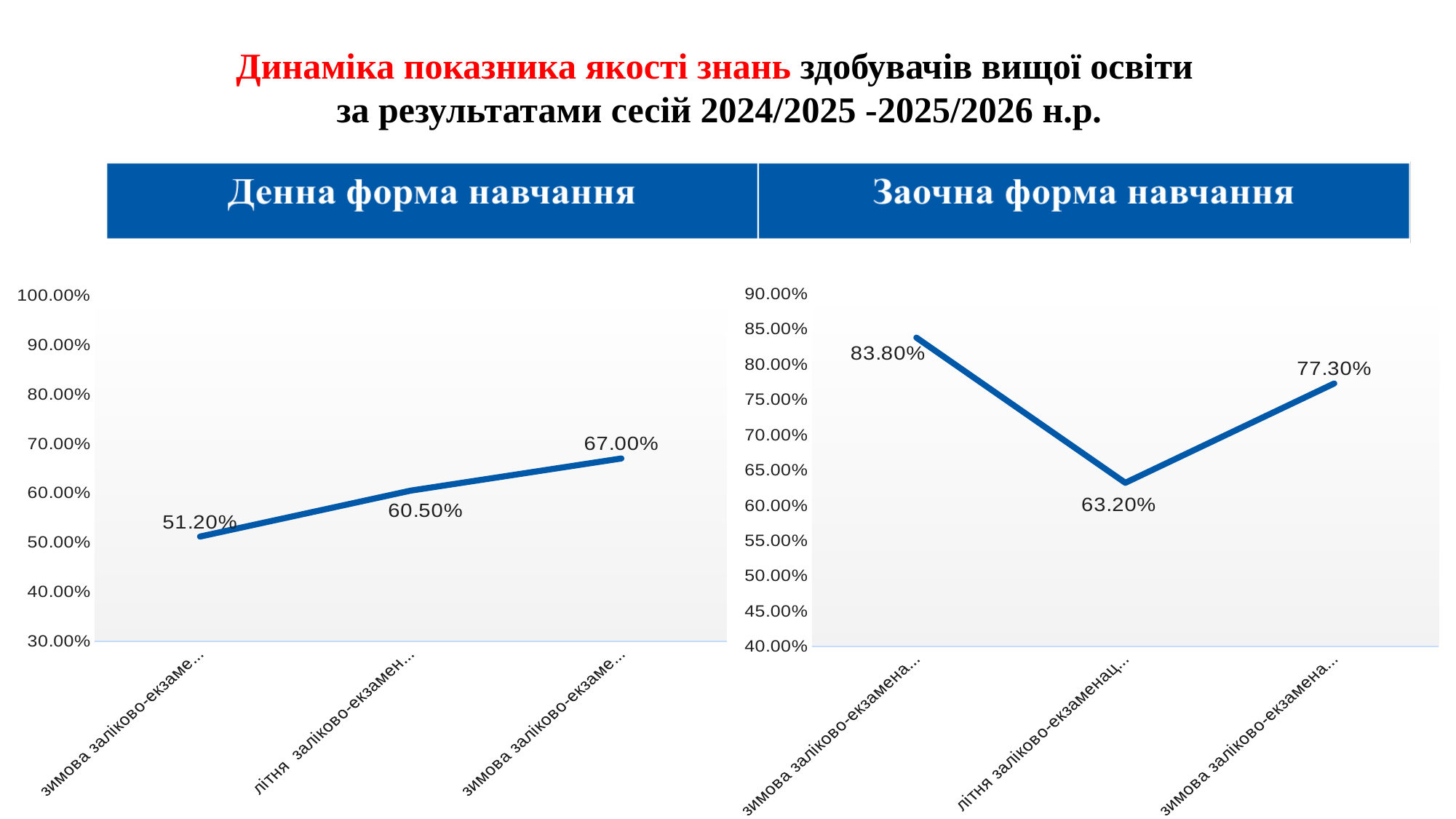
On the 'Заочна форма навчання' chart, what is the value of the second data point? 63.20% On the 'Денна форма навчання' chart, what is the difference between the last and the first data point? 15.80% On the 'Заочна форма навчання' chart, what is the value of the last data point? 77.30% How many data points are plotted on the 'Денна форма навчання' chart? 3 On the 'Денна форма навчання' chart, what is the value of the middle data point? 60.50% What type of chart is used for 'Заочна форма навчання'? Line chart On the 'Денна форма навчання' chart, what is the value of the first data point? 51.20% Which is larger: the last value on the 'Денна форма навчання' chart or the last value on the 'Заочна форма навчання' chart? The last value on the 'Заочна форма навчання' chart (77.30%) On the 'Денна форма навчання' chart, which data point has the lowest value? The first point (51.20%) On the 'Денна форма навчання' chart, do the values rise or fall from left to right? Rise On the 'Заочна форма навчання' chart, what is the difference between the first and the second data point? 20.60% On the 'Заочна форма навчання' chart, which data point has the highest value? The first point (83.80%)